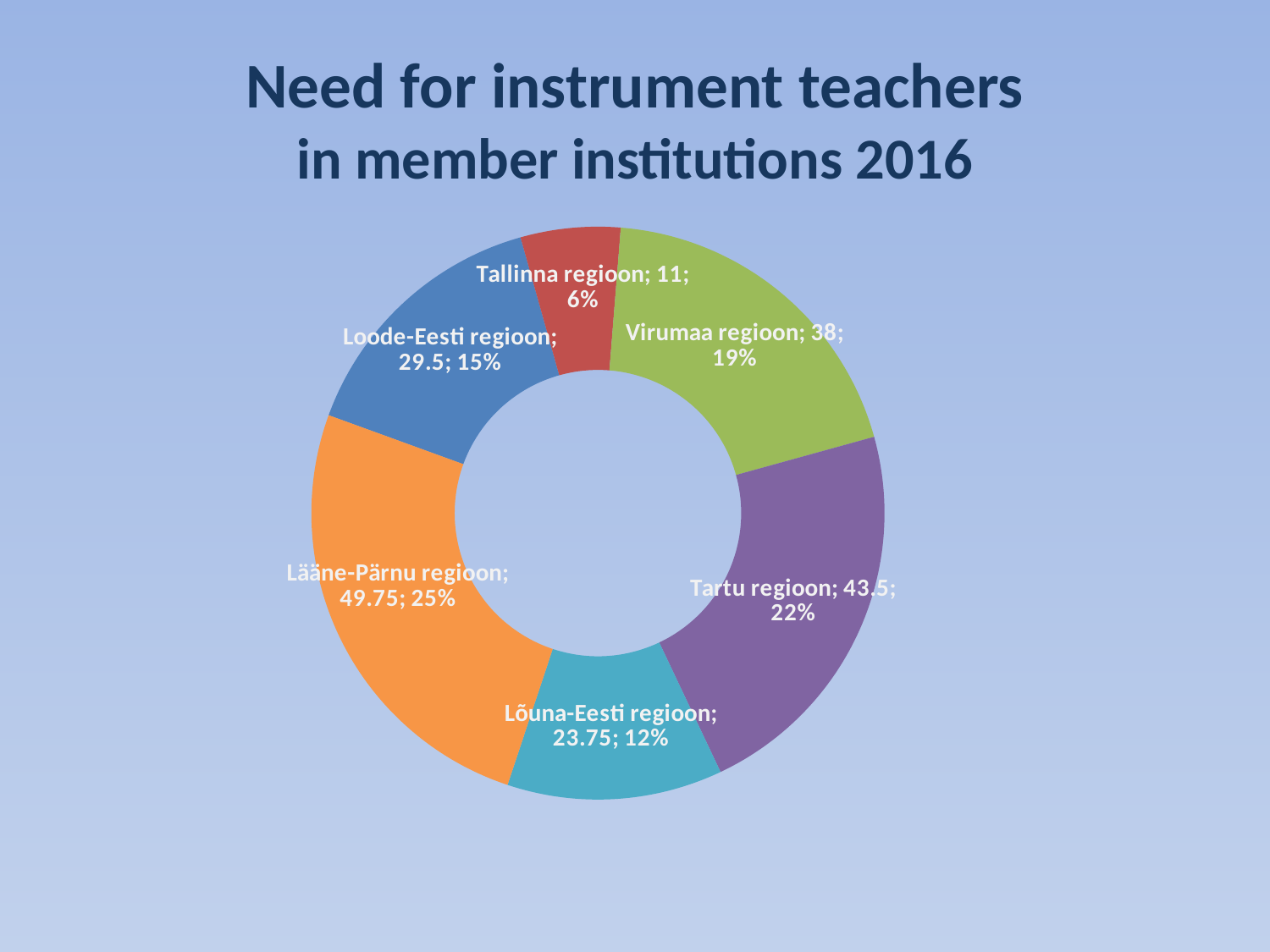
What is the difference between the values for Tartu regioon and Virumaa regioon? 5.5 Which region has the smallest slice? Tallinna regioon Which region has the largest slice? Lääne-Pärnu regioon How many regions are shown in the chart? 6 What percentage share does Tartu regioon have? 22% What value is shown for Lääne-Pärnu regioon? 49.75 What value is shown for Virumaa regioon? 38 What percentage share does Tallinna regioon have? 6% What colour is the slice for Lääne-Pärnu regioon? Orange Which is larger, the value for Loode-Eesti regioon or Lõuna-Eesti regioon? Loode-Eesti regioon What is the title of the chart? Need for instrument teachers in member institutions 2016 What kind of chart is shown on the slide? Doughnut (pie) chart